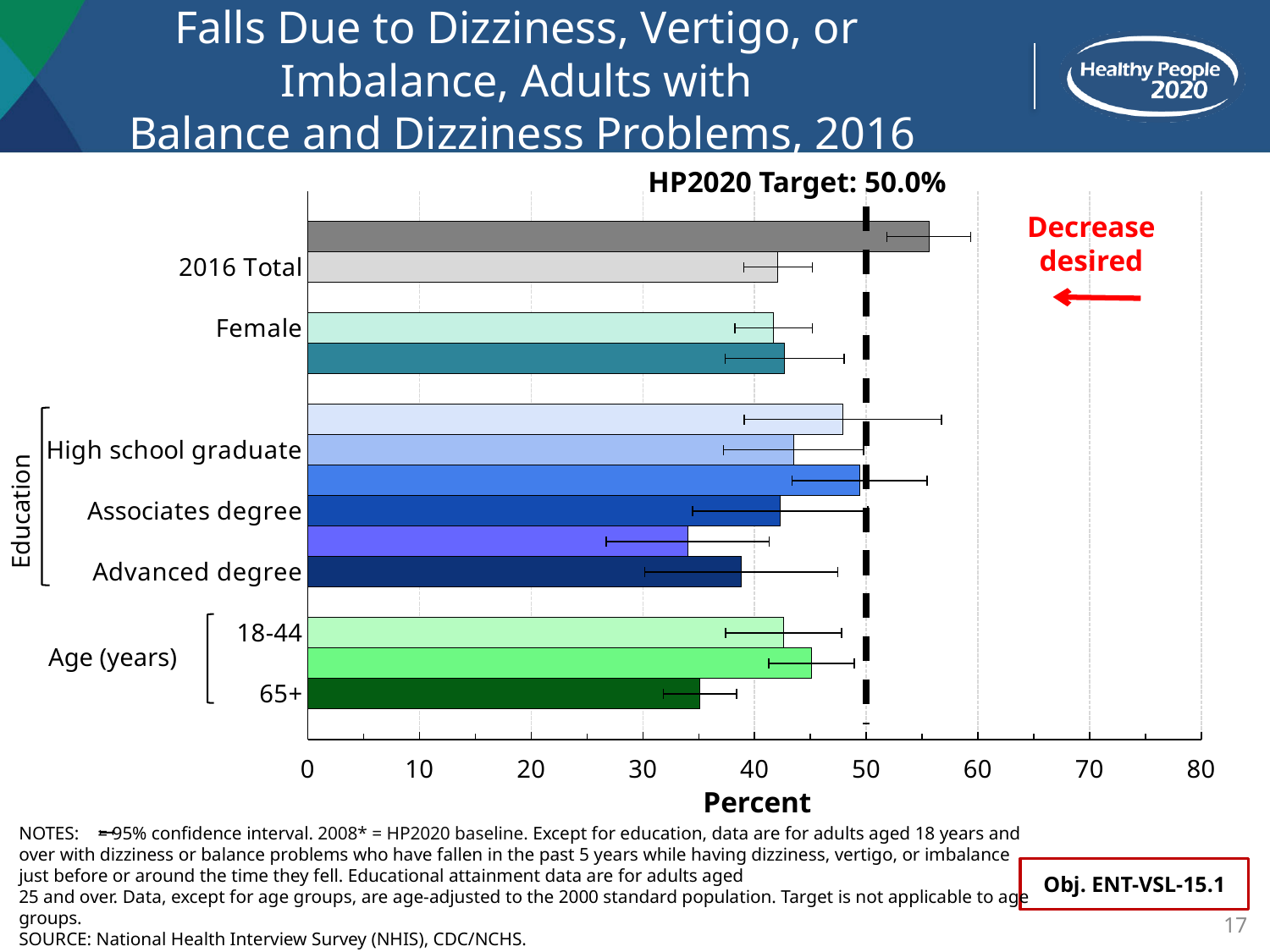
Which has the larger value, Advanced degree or 65+? Advanced degree What is the HP2020 Target value shown on the chart? 50.0% Is the value for 18-44 greater or less than 40? greater Is the value for Associates degree greater or less than 50? less How many bars are plotted in the Education group? 6 Is the value for High school graduate greater or less than 40? greater What is the label of the x axis? Percent What type of chart is shown on the slide? bar chart Which has the larger value, 18-44 or 65+? 18-44 Which has the larger value, High school graduate or Advanced degree? High school graduate